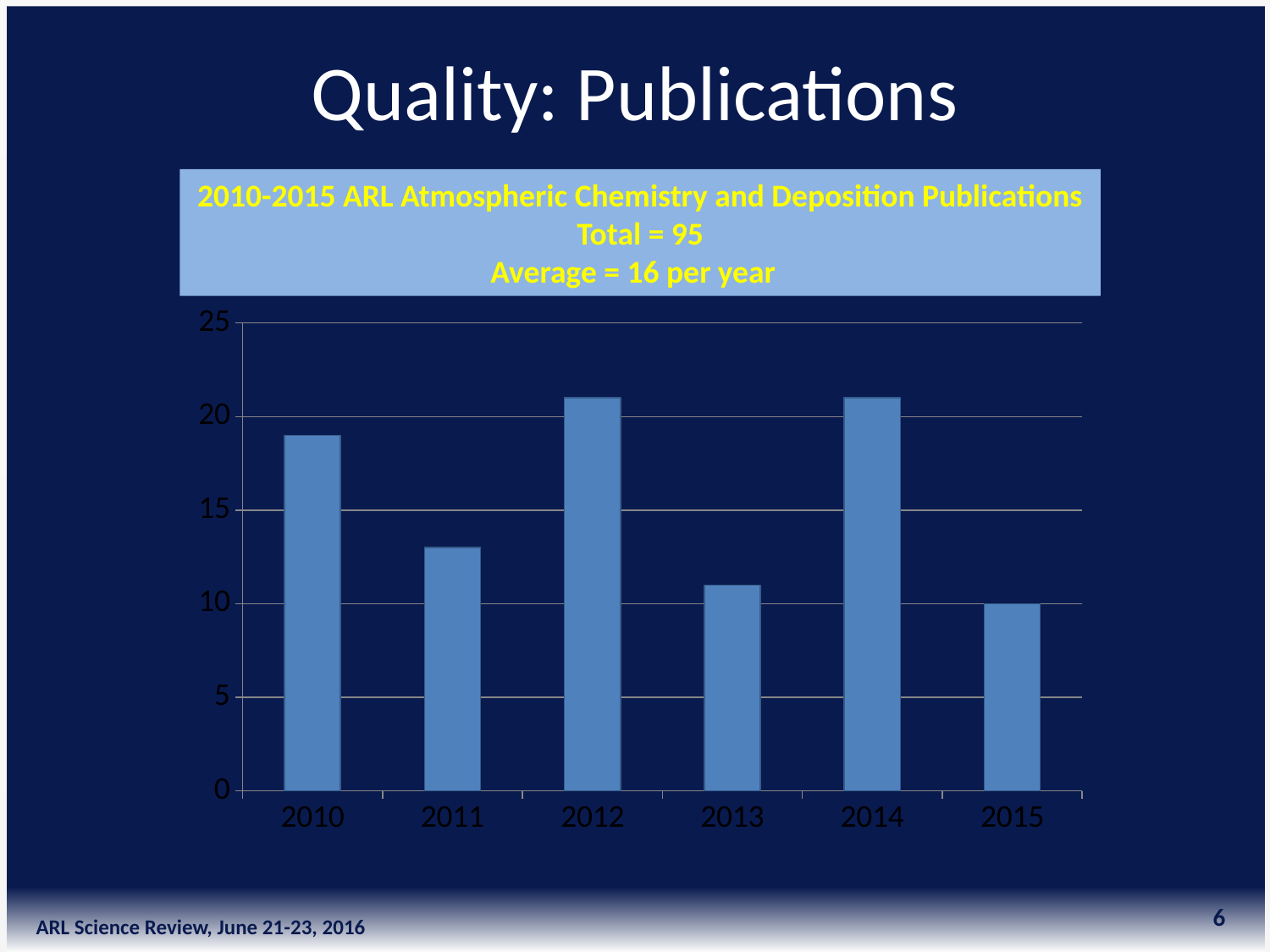
Is the value for 2012 greater or less than 20? greater According to the chart's title box, what is the average number of publications per year? 16 per year Which year has the larger value, 2013 or 2014? 2014 What kind of chart is shown on the slide? bar chart According to the chart's title box, what is the total number of publications for 2010-2015? 95 How many years are shown on the x axis of the chart? 6 Is the value for 2011 greater or less than 15? less What is the value for 2015? 10 Is the value for 2014 greater or less than 20? greater Which year has the larger value, 2010 or 2011? 2010